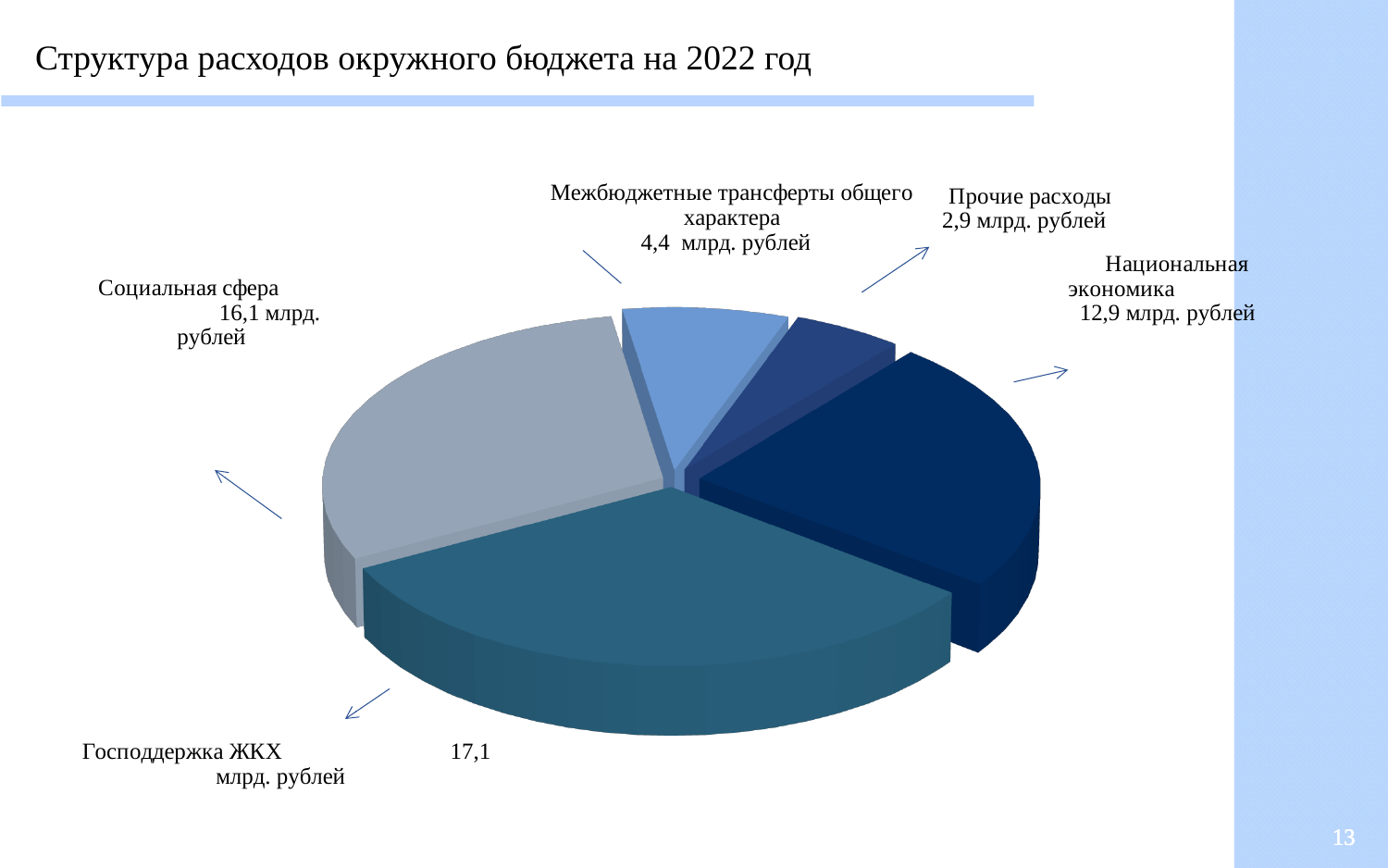
What is the difference between the values for Господдержка ЖКХ and Социальная сфера? 1,0 млрд. рублей How many slices does the pie chart have? 5 What kind of chart is shown on the slide? Pie chart What is the value for Межбюджетные трансферты общего характера? 4,4 млрд. рублей Which category has the smallest value in the pie chart? Прочие расходы Which category has the largest value in the pie chart? Господдержка ЖКХ What is the difference between the values for Социальная сфера and Национальная экономика? 3,2 млрд. рублей What is the title of the chart on the slide? Структура расходов окружного бюджета на 2022 год What is the value for Прочие расходы? 2,9 млрд. рублей What is the value for Социальная сфера? 16,1 млрд. рублей Which is larger, the value for Национальная экономика or the value for Межбюджетные трансферты общего характера? Национальная экономика What is the value for Национальная экономика? 12,9 млрд. рублей